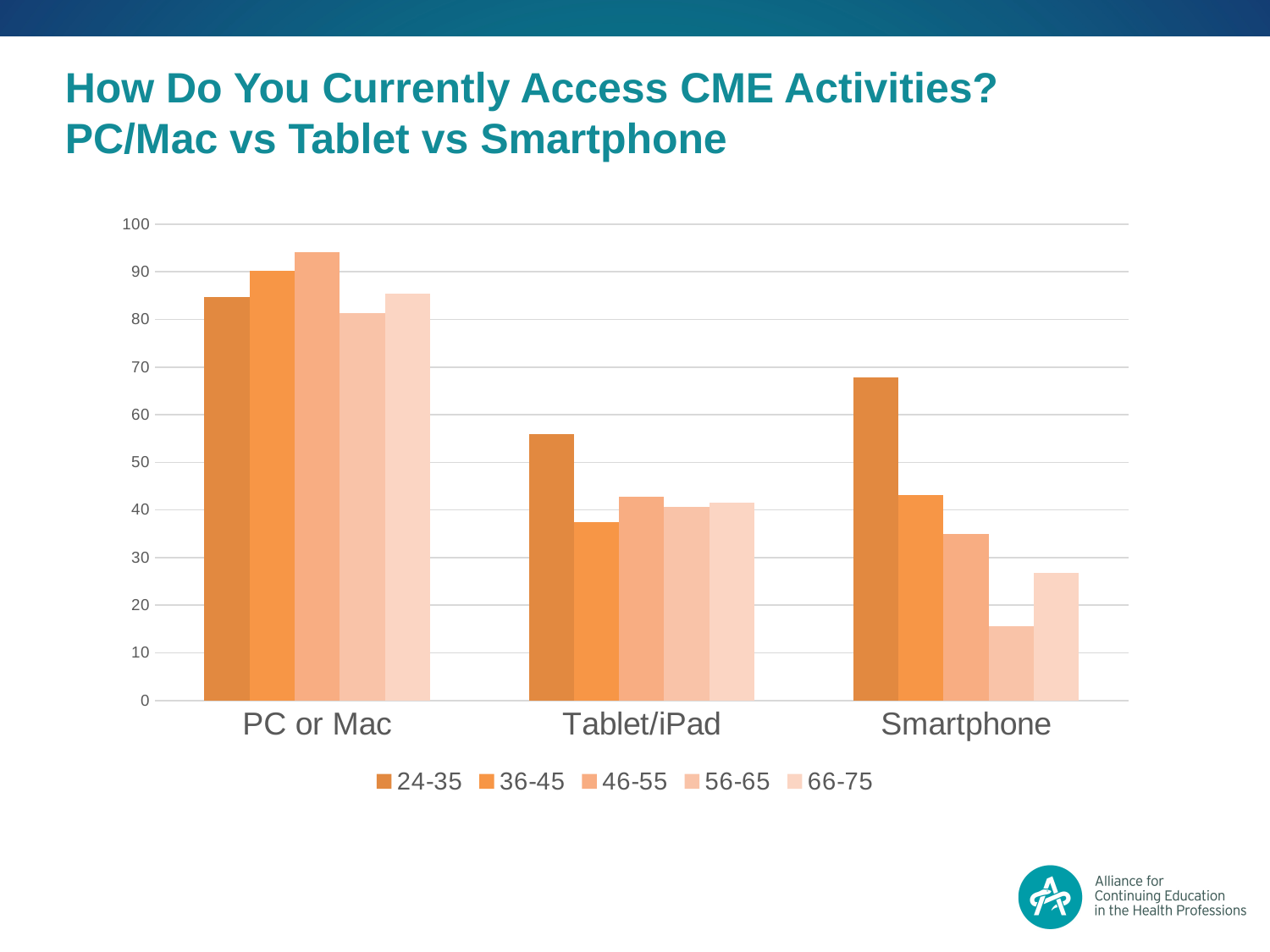
Which category has the tallest bars overall? PC or Mac In the Tablet/iPad category, which is larger: the 24-35 group or the 36-45 group? 24-35 How many categories are shown on the x axis? 3 Which age group has the shortest bar in the Smartphone category? 56-65 Which age group has the tallest bar in the Tablet/iPad category? 24-35 What is the title of the slide containing the chart? How Do You Currently Access CME Activities? PC/Mac vs Tablet vs Smartphone Which age group has the tallest bar in the Smartphone category? 24-35 Is the value for the 36-45 group in the PC or Mac category greater or less than 80? greater Is the value for the 56-65 group in the Smartphone category greater or less than 20? less What kind of chart is shown on the slide? bar chart Is the value for the 24-35 group in the Smartphone category greater or less than 60? greater How many series does the legend list? 5